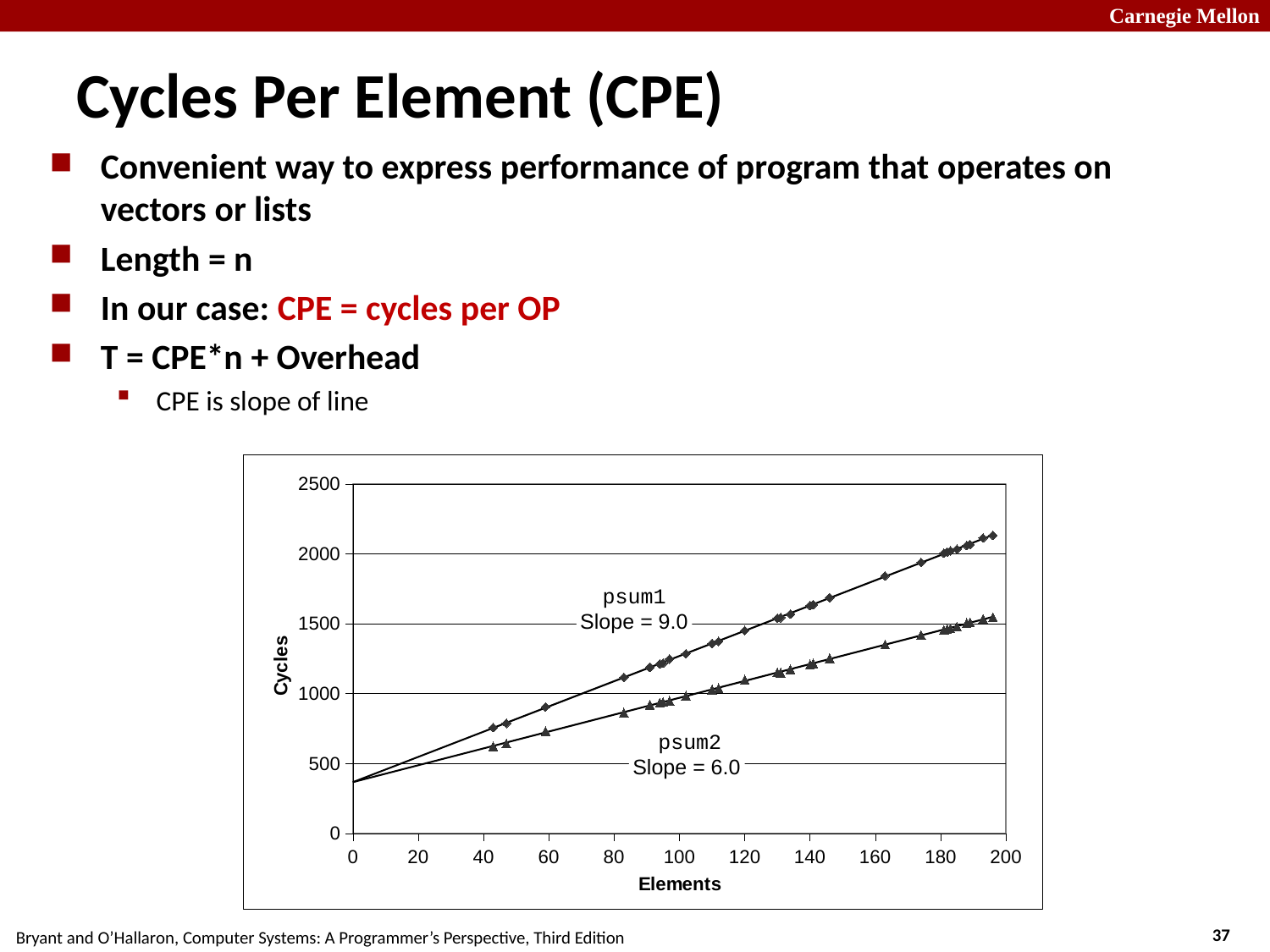
What is the slope shown for the psum1 series? 9.0 Do the Cycles values rise or fall as the number of Elements increases? rise Which series reaches the higher number of cycles at the right end of the chart? psum1 Is the psum2 value at about 195 elements greater or less than 2000 cycles? less How many data series are plotted on the chart? 2 Is the psum1 value at about 100 elements greater or less than 1000 cycles? greater What is the label of the x axis? Elements Is the psum1 value at about 195 elements greater or less than 2000 cycles? greater What kind of chart is shown on the slide? line chart What is the slope shown for the psum2 series? 6.0 What is the label of the y axis? Cycles Which series has the larger slope, psum1 or psum2? psum1